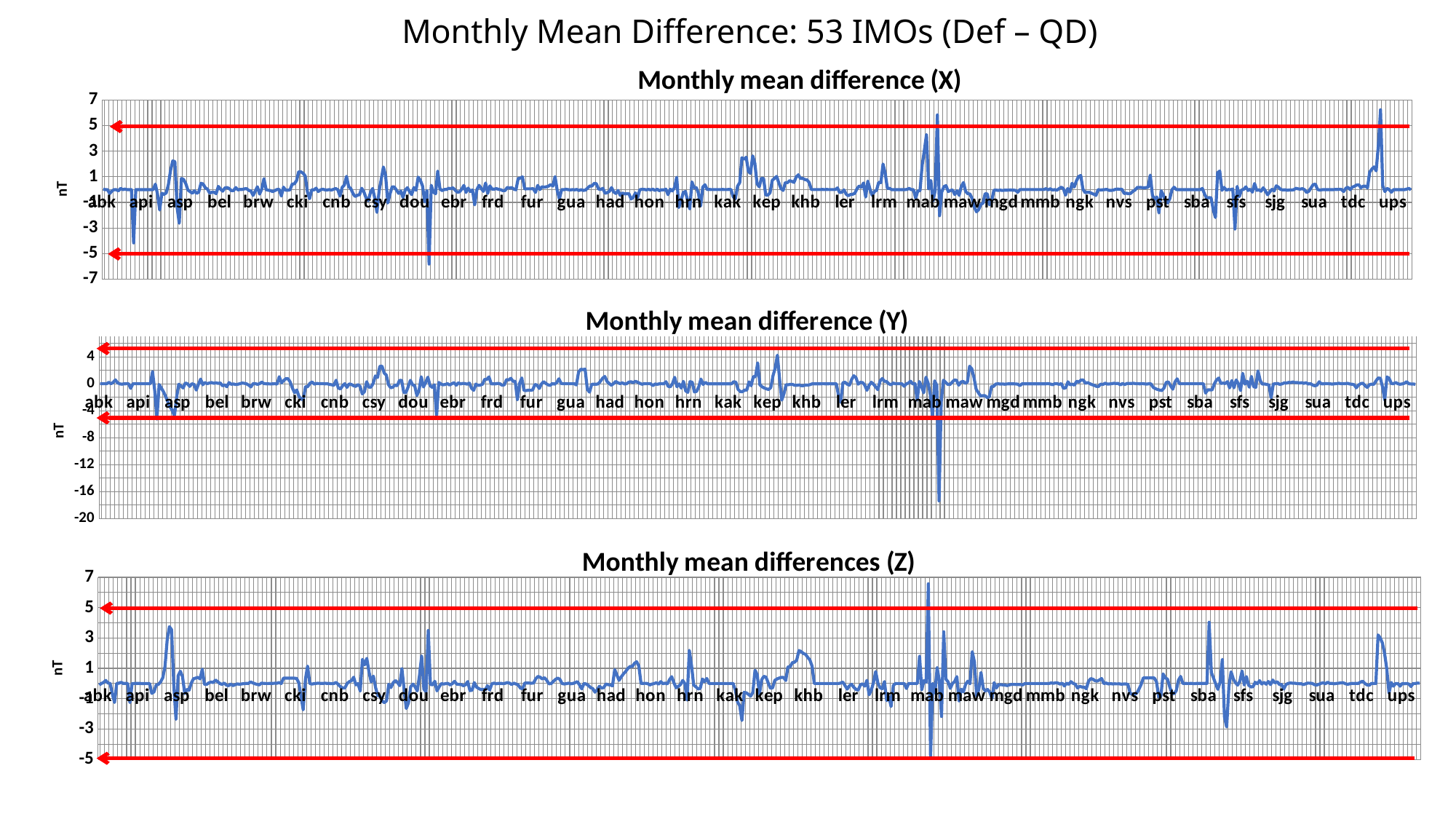
What is the y-axis label on the "Monthly mean difference (Y)" chart? nT In the "Monthly mean differences (Z)" chart, is the highest peak near mab greater or less than 5? greater In the "Monthly mean differences (Z)" chart, which peak is higher: the one near asp or the one near mab? mab How many charts are shown on the slide? 3 What is the title of the bottom chart on the slide? Monthly mean differences (Z) In the "Monthly mean difference (X)" chart, is the lowest value near dou greater or less than -5? less In the "Monthly mean differences (Z)" chart, near which station label does the line reach its highest value? mab What is the lowest value shown on the y-axis of the "Monthly mean difference (Y)" chart? -20 What kind of chart is "Monthly mean difference (X)"? line chart In the "Monthly mean difference (X)" chart, is the peak value near ups greater or less than 5? greater In the "Monthly mean difference (Y)" chart, near which station label does the line reach its lowest value? mab